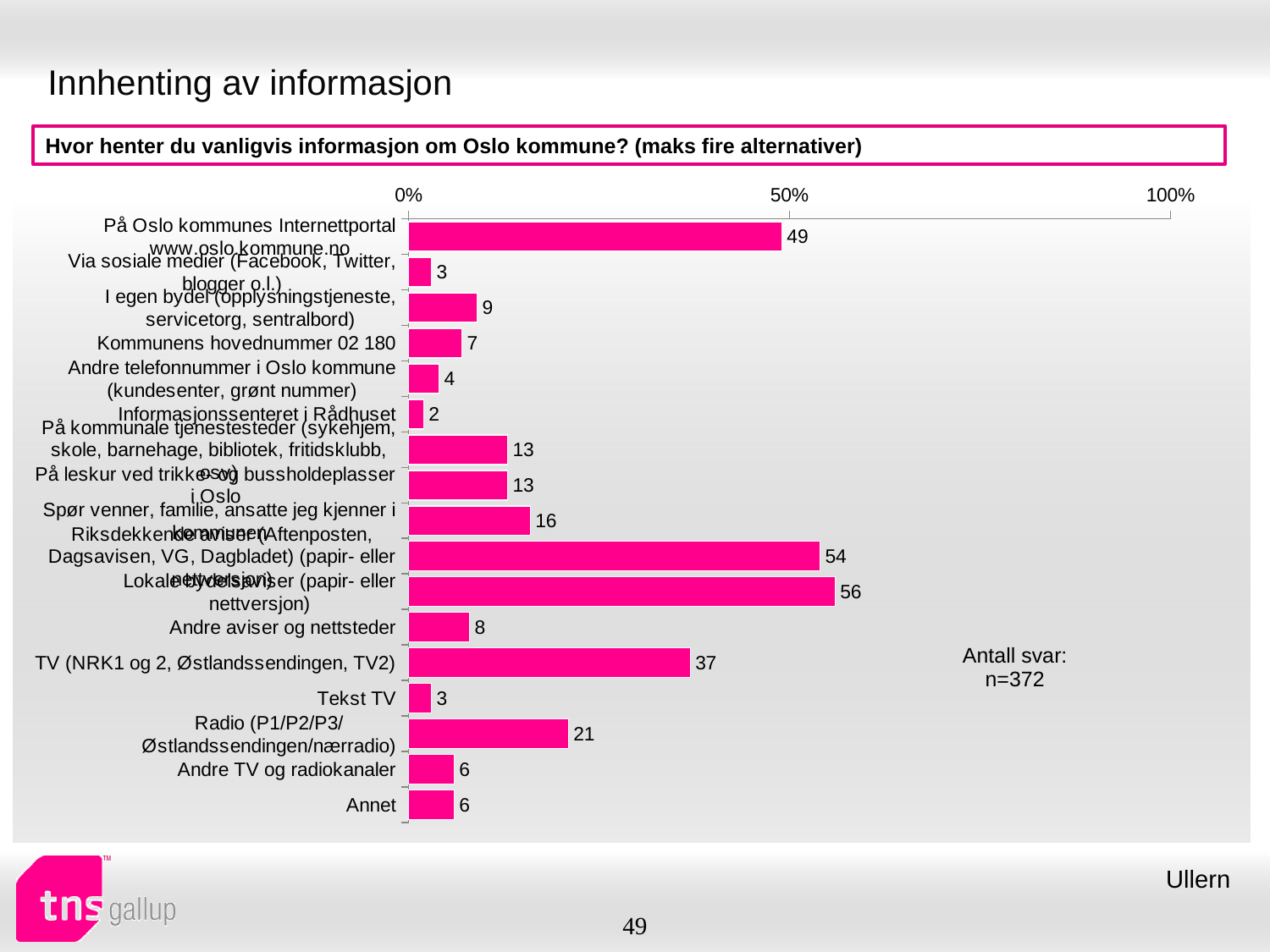
Which is larger: the value for "Radio (P1/P2/P3/Østlandssendingen/nærradio)" or the value for "Andre TV og radiokanaler"? Radio (P1/P2/P3/Østlandssendingen/nærradio) Is the value for "På Oslo kommunes Internettportal www.oslo.kommune.no" greater or less than 50%? less What is the value for "Andre aviser og nettsteder"? 8 What is the value for "TV (NRK1 og 2, Østlandssendingen, TV2)"? 37 What is the value for "Kommunens hovednummer 02 180"? 7 How many categories are shown in the chart? 17 What is the number of respondents (Antall svar) stated on the slide? n=372 Which category has the highest value? Lokale bydelsaviser (papir- eller nettversjon) What is the value for "Tekst TV"? 3 What kind of chart is shown on the slide? bar chart Which category has the lowest value? Informasjonssenteret i Rådhuset What is the difference between the values for "Lokale bydelsaviser" and "Riksdekkende aviser"? 2